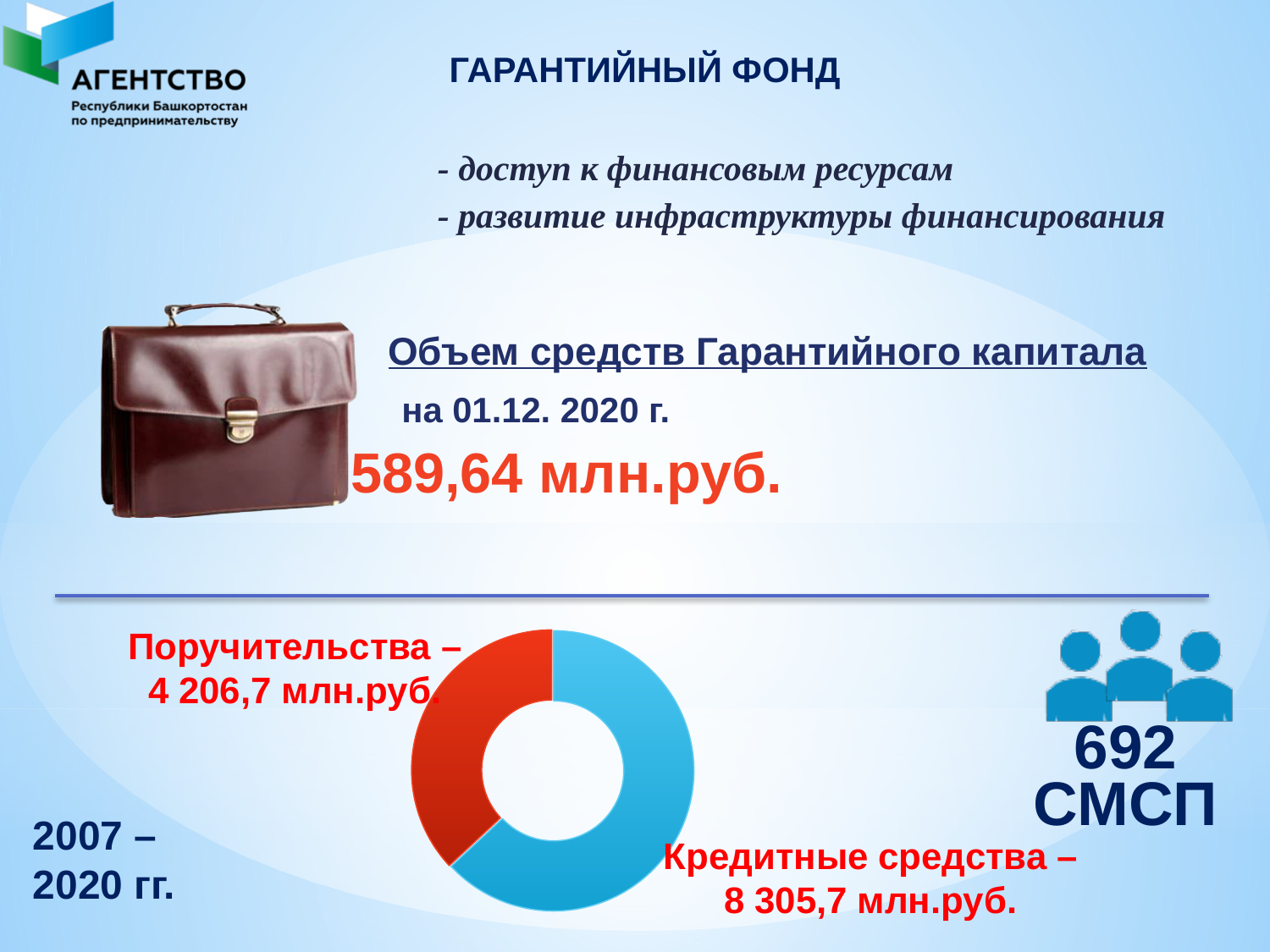
How many segments does the doughnut chart have? 2 Which segment of the doughnut chart is the largest? Кредитные средства What period does the doughnut chart cover, according to the label on the slide? 2007 – 2020 гг. Which segment of the doughnut chart is the smallest? Поручительства What colour is the Поручительства segment in the doughnut chart? red What kind of chart is shown at the bottom of the slide? doughnut chart What is the value for Кредитные средства in the doughnut chart? 8 305,7 млн.руб. What is the difference between Кредитные средства and Поручительства in the doughnut chart? 4 099,0 млн.руб. What is the value for Поручительства in the doughnut chart? 4 206,7 млн.руб. What is the total of the two segments in the doughnut chart? 12 512,4 млн.руб. Which is larger in the doughnut chart, Поручительства or Кредитные средства? Кредитные средства